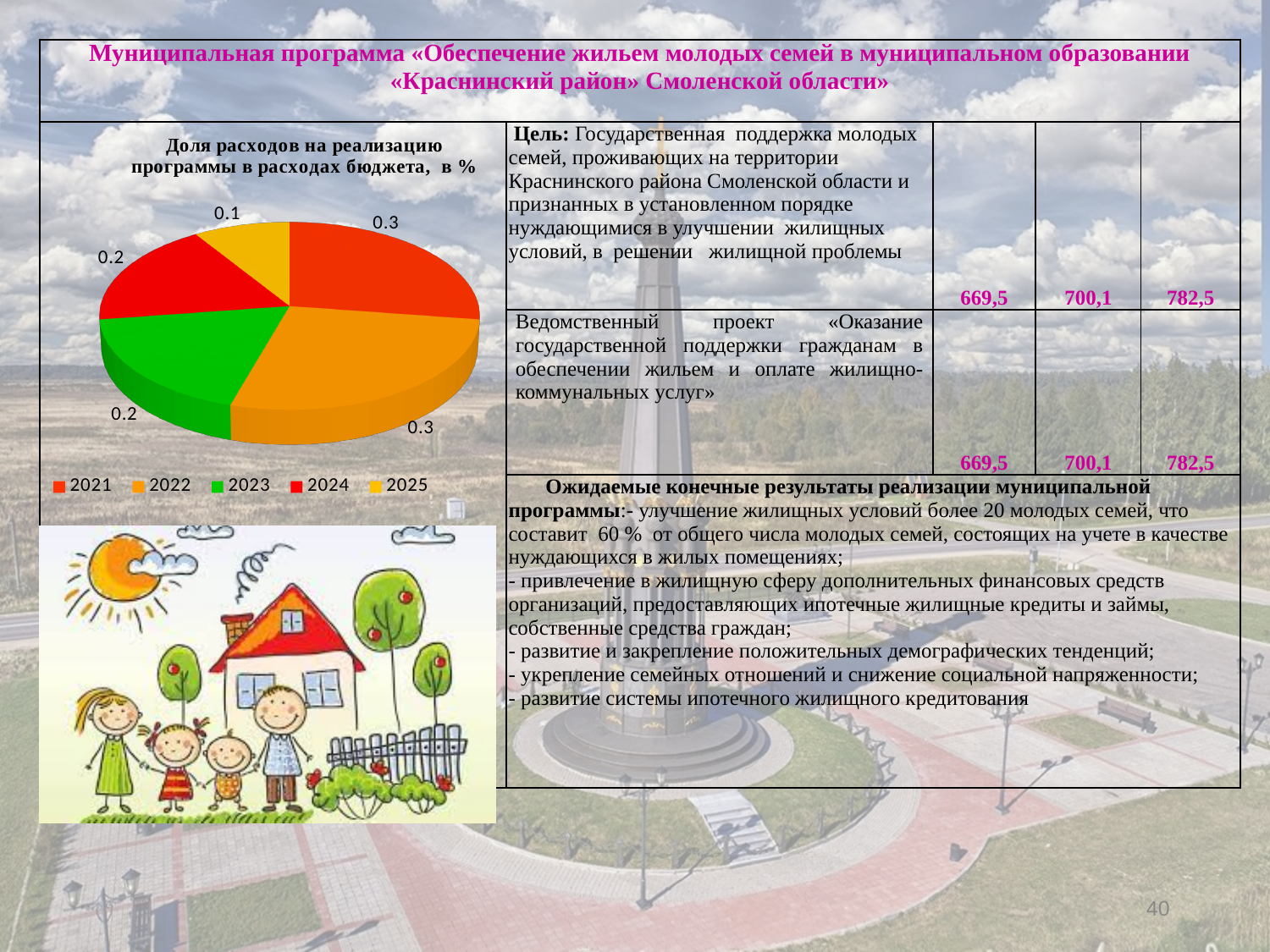
What is the value for 2023 in the pie chart? 0.2 Which is larger in the pie chart, the value for 2021 or the value for 2025? 2021 What is the difference between the values for 2021 and 2025 in the pie chart? 0.2 What kind of chart is shown on the slide? pie chart Which legend entry is shown in green in the pie chart? 2023 What is the value for 2021 in the pie chart? 0.3 What is the value for 2022 in the pie chart? 0.3 How many slices does the pie chart have? 5 What is the title of the pie chart? Доля расходов на реализацию программы в расходах бюджета, в % How many entries does the legend of the pie chart list? 5 What is the value for 2025 in the pie chart? 0.1 Which year has the smallest slice in the pie chart? 2025